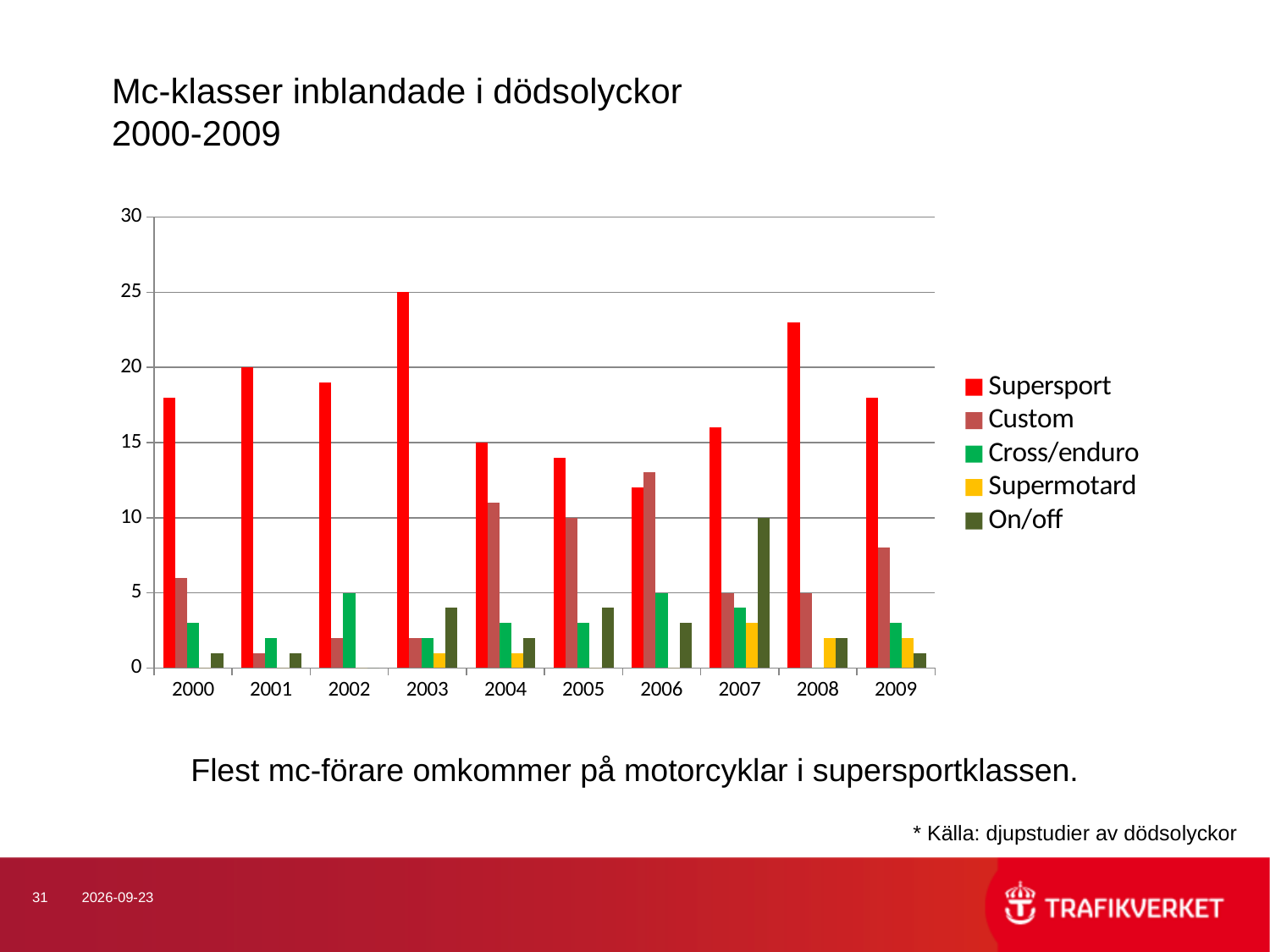
Is the Custom value for 2004 greater or less than 10? greater Is the Supersport value for 2008 greater or less than 20? greater What is the On/off value for 2007? 10 What kind of chart is shown on the slide? Bar chart In which year is the Supersport value highest? 2003 In 2007, which is larger, the On/off value or the Custom value? On/off Which series is shown in red in the legend? Supersport What is the Custom value for 2005? 10 How many years are shown on the x axis? 10 What is the Supersport value for 2001? 20 What is the Supersport value for 2003? 25 How many series does the legend list? 5